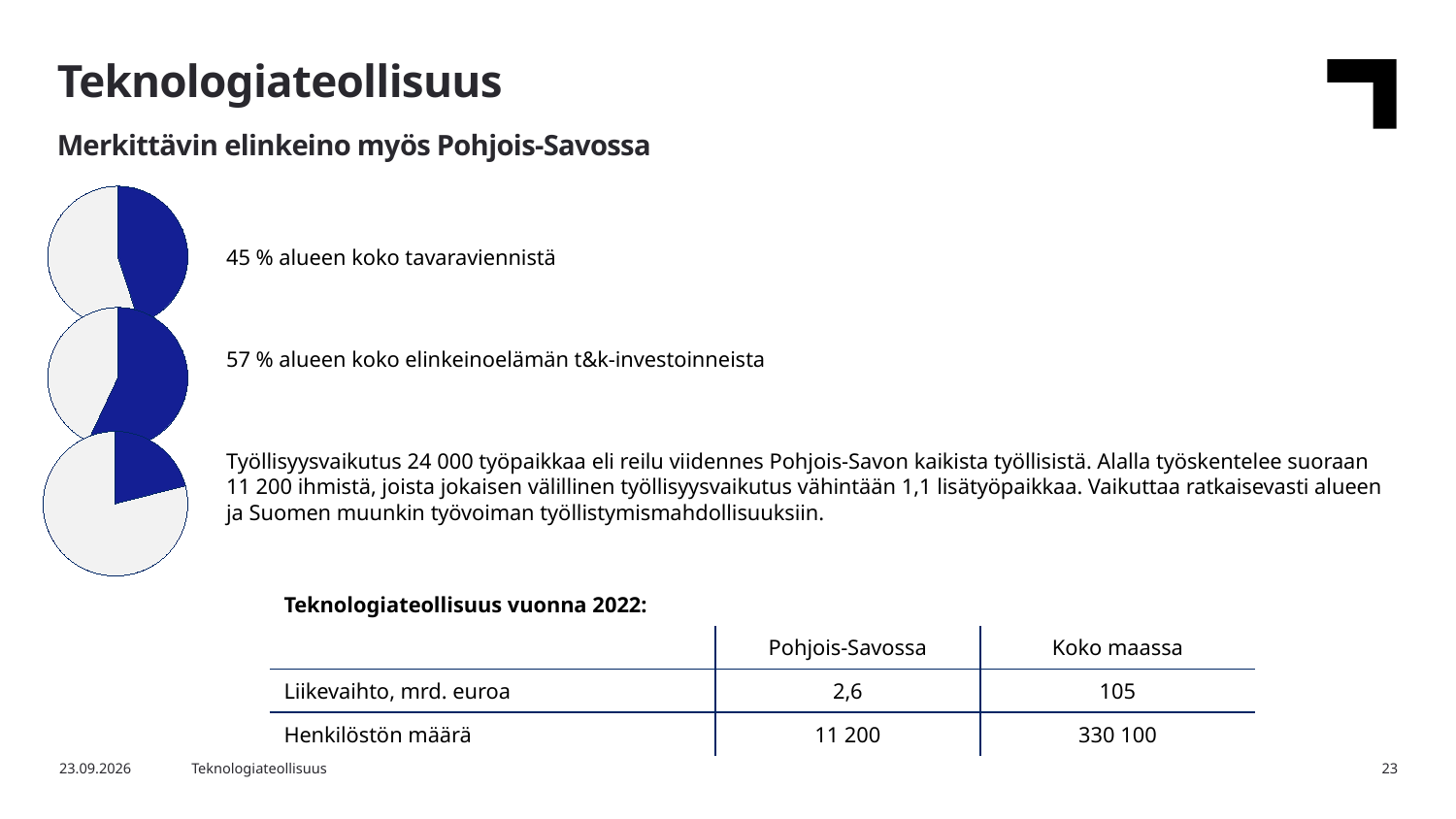
In the middle pie chart, is the blue slice greater or less than 50% of the pie? greater Which of the three pie charts has the smallest blue slice? The bottom one What colour is the highlighted slice in each pie chart? Blue What does the top pie chart represent according to the text next to it? Share of the region's total goods exports (alueen koko tavaravienti) Which pie chart has the larger blue slice, the top one or the middle one? The middle one Which of the three pie charts has the largest blue slice? The middle one How many slices does each pie chart have? 2 What kind of charts are the three charts on the left side of the slide? Pie charts How many pie charts are shown on the slide? 3 In the bottom pie chart, is the blue slice greater or less than 50% of the pie? less In the top pie chart, what share of the region's total goods exports (tavaravienti) does the blue slice represent? 45 % In the middle pie chart, what share of the region's business R&D investments (t&k-investoinnit) does the blue slice represent? 57 %